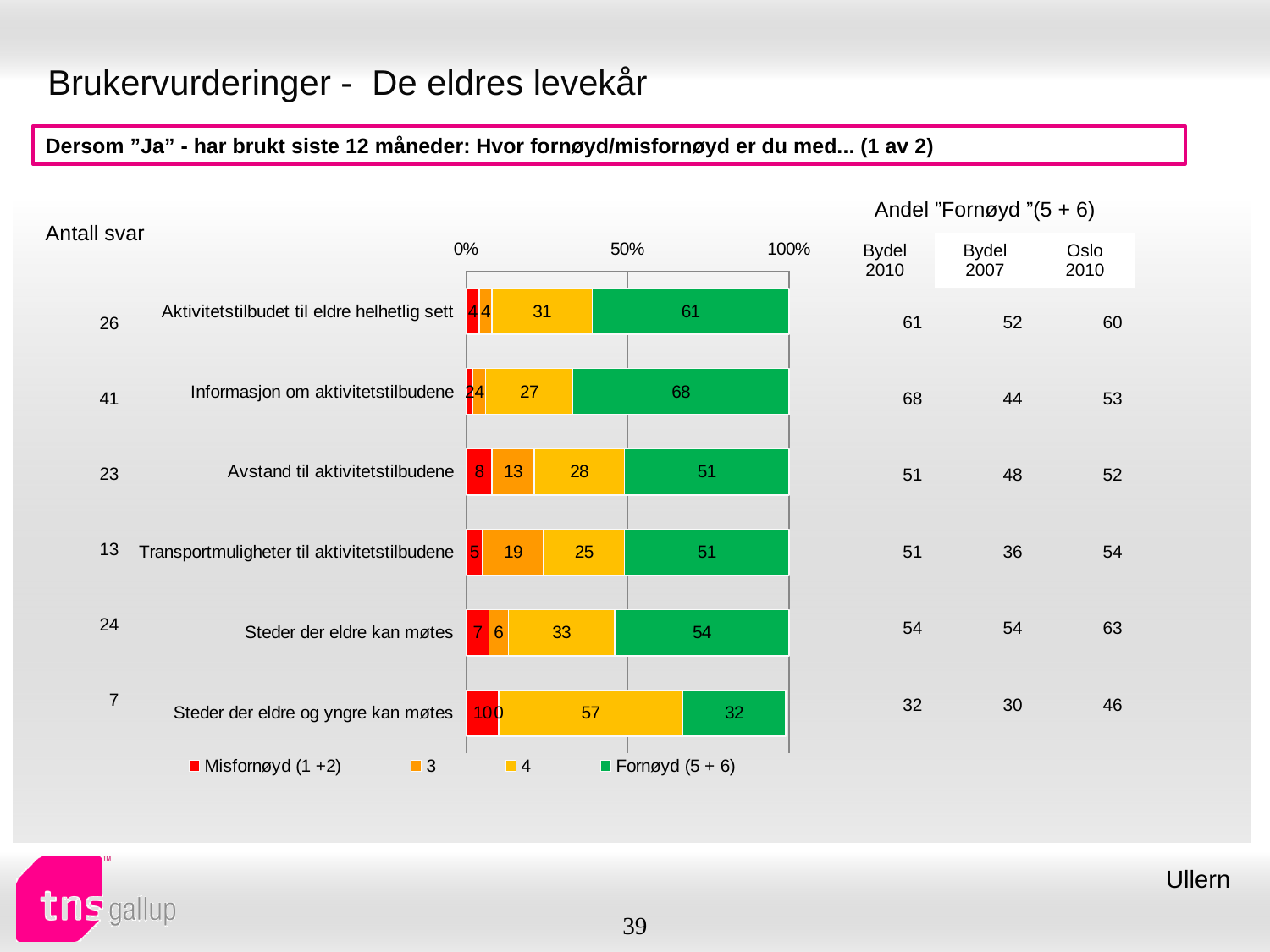
Which category has the lowest Fornøyd (5 + 6) value? Steder der eldre og yngre kan møtes Which has the larger Fornøyd (5 + 6) value: Steder der eldre kan møtes or Avstand til aktivitetstilbudene? Steder der eldre kan møtes What is the value of the series labelled 3 for Transportmuligheter til aktivitetstilbudene? 19 What is the value of the Fornøyd (5 + 6) series for Informasjon om aktivitetstilbudene? 68 What is the value of the series labelled 4 for Steder der eldre og yngre kan møtes? 57 What kind of chart is shown on the slide? Stacked bar chart What is the difference between the Fornøyd (5 + 6) values for Aktivitetstilbudet til eldre helhetlig sett and Steder der eldre og yngre kan møtes? 29 What is the Misfornøyd (1 +2) value for Avstand til aktivitetstilbudene? 8 Which category has the highest Fornøyd (5 + 6) value? Informasjon om aktivitetstilbudene How many categories are shown in the chart? 6 How many series does the legend list? 4 What colour represents the Fornøyd (5 + 6) series in the chart? Green